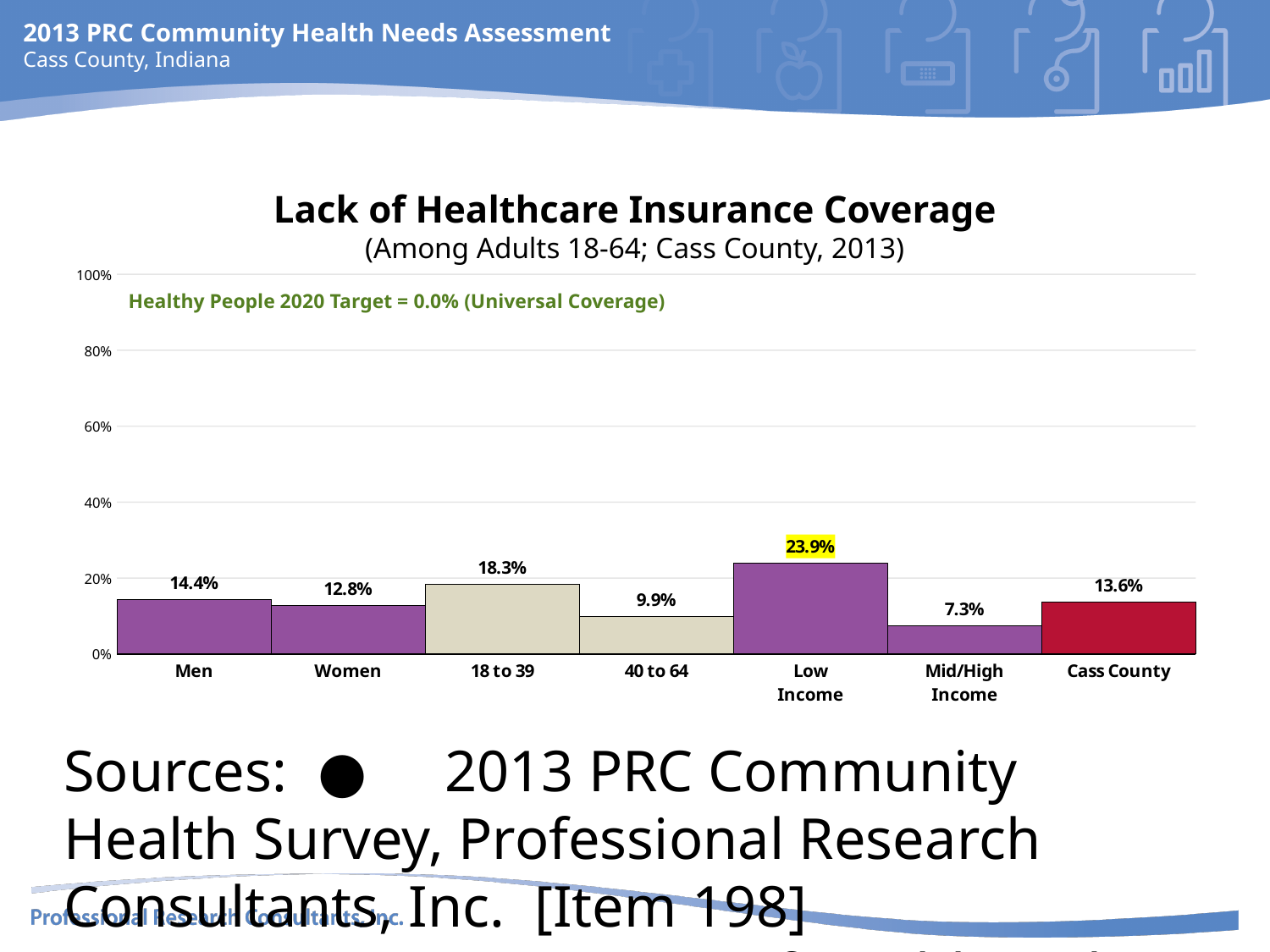
How many categories are shown on the x axis? 7 What is the difference between the values for Men and Women? 1.6% Which category has the lowest value? Mid/High Income Which is larger, the value for 18 to 39 or the value for 40 to 64? 18 to 39 What kind of chart is this? bar chart What is the value for Men? 14.4% What is the value for Cass County? 13.6% What is the Healthy People 2020 Target shown on the chart? 0.0% (Universal Coverage) What is the value for Low Income? 23.9% Which category has the highest value? Low Income Is the value for Low Income greater or less than 20%? greater What is the difference between the values for Low Income and Mid/High Income? 16.6%